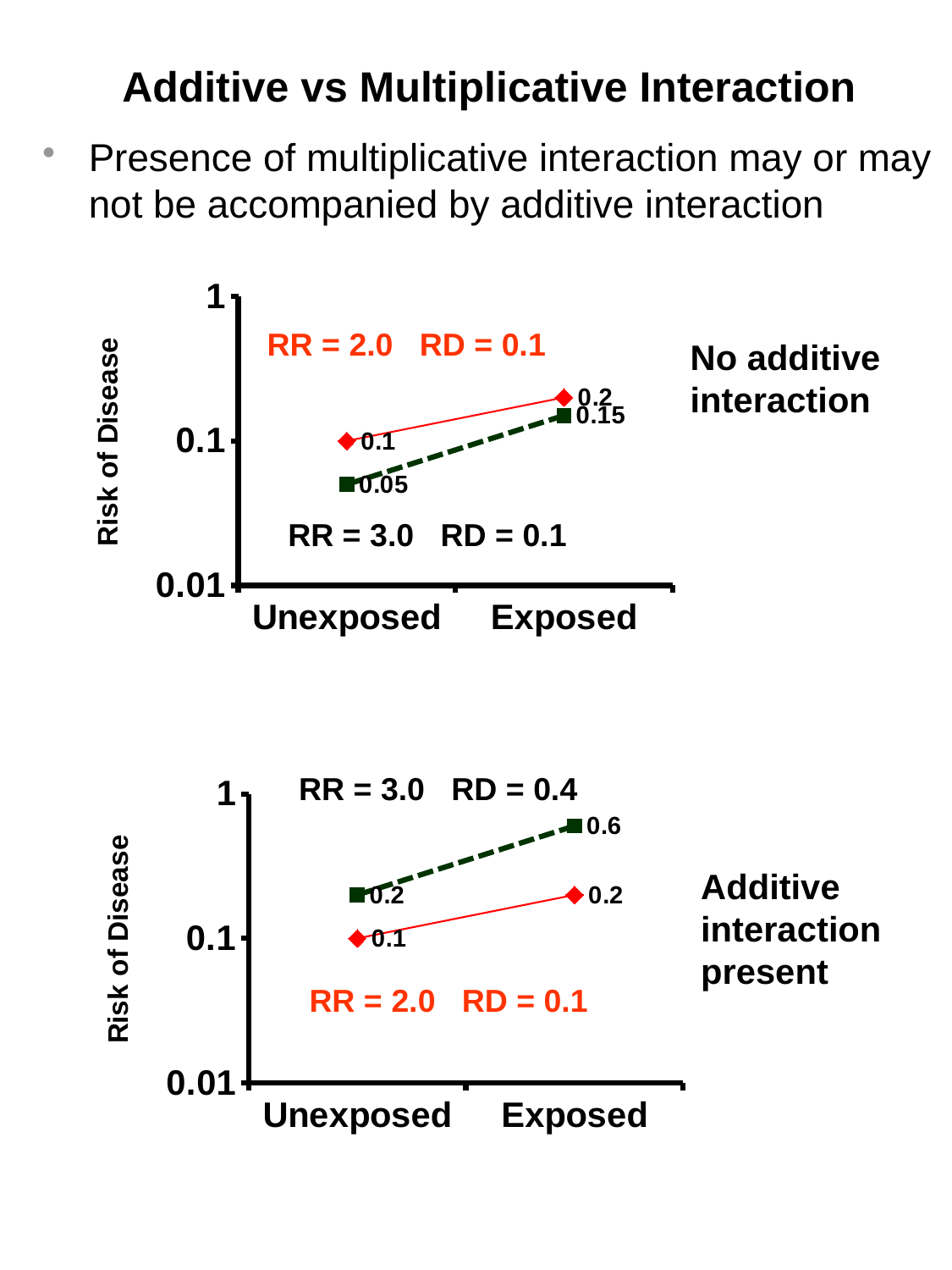
What kind of chart is the top chart (No additive interaction)? line chart In the bottom chart (Additive interaction present), which group has the higher risk on the green dashed line, Unexposed or Exposed? Exposed In the top chart (No additive interaction), what is the risk of disease for the Unexposed group on the green dashed line? 0.05 In the bottom chart (Additive interaction present), what is the difference in risk between Exposed and Unexposed on the green dashed line? 0.4 In the top chart (No additive interaction), does the risk of disease rise or fall from Unexposed to Exposed on the green dashed line? rise How many categories are shown on the x axis of the bottom chart (Additive interaction present)? 2 In the top chart (No additive interaction), what is the risk of disease for the Exposed group on the red solid line? 0.2 In the bottom chart (Additive interaction present), what is the risk of disease for the Exposed group on the green dashed line? 0.6 In the top chart (No additive interaction), what is the risk of disease for the Exposed group on the green dashed line? 0.15 In the top chart (No additive interaction), what is the difference in risk between Exposed and Unexposed on the red solid line? 0.1 In the bottom chart (Additive interaction present), what is the risk of disease for the Unexposed group on the red solid line? 0.1 What is the y-axis label of the bottom chart (Additive interaction present)? Risk of Disease